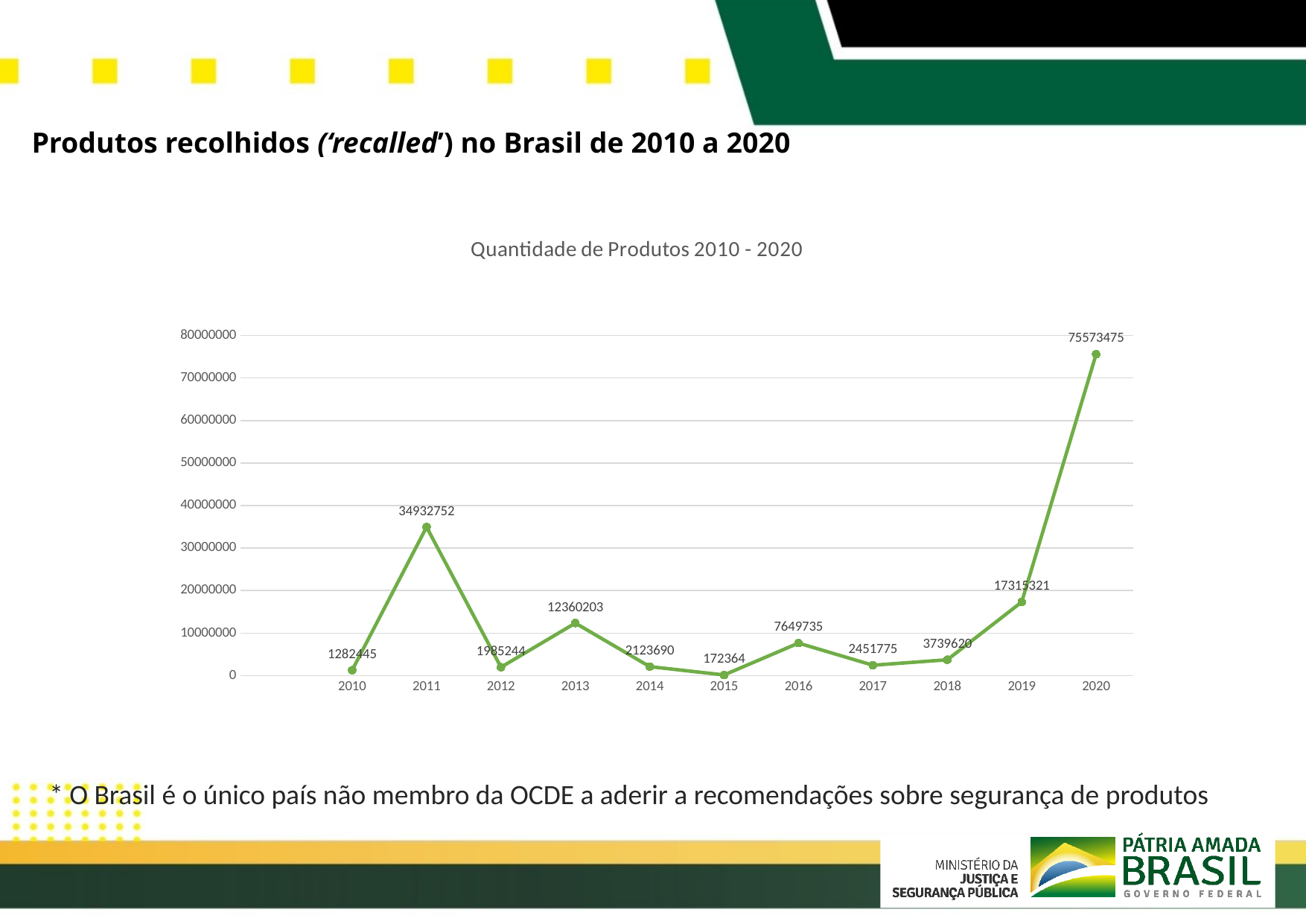
Which year has the lowest value? 2015 What is the difference between the values for 2019 and 2018? 13575701 Which year has the highest value? 2020 What is the value for 2015? 172364 Is the value for 2019 greater or less than 20000000? less What is the value for 2011? 34932752 What is the difference between the values for 2020 and 2011? 40640723 How many years are plotted on the chart? 11 What is the value for 2013? 12360203 What is the value for 2020? 75573475 Which is larger, the value for 2016 or the value for 2017? 2016 What kind of chart is shown on the slide? line chart